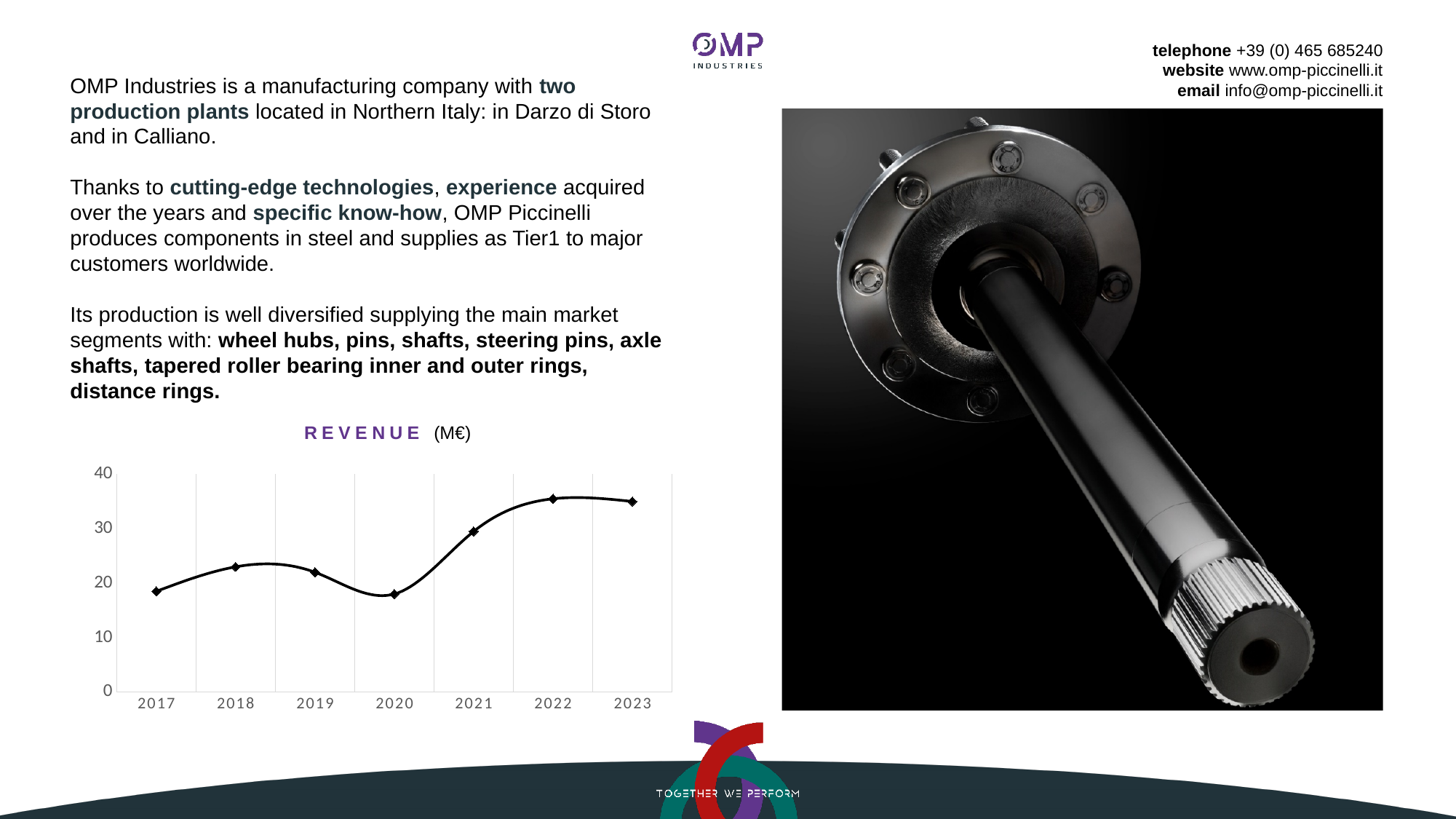
How many years are plotted on the REVENUE chart? 7 Which year has the higher revenue, 2020 or 2022? 2022 Does revenue rise or fall from 2020 to 2022? rise Which year has the higher revenue, 2018 or 2021? 2021 Is the revenue value for 2020 greater or less than 20? less Is the revenue value for 2022 greater or less than 30? greater What unit is given next to the REVENUE chart title? M€ Is the revenue value for 2017 greater or less than 20? less What is the first year shown on the x axis of the REVENUE chart? 2017 What kind of chart is the REVENUE chart? line chart